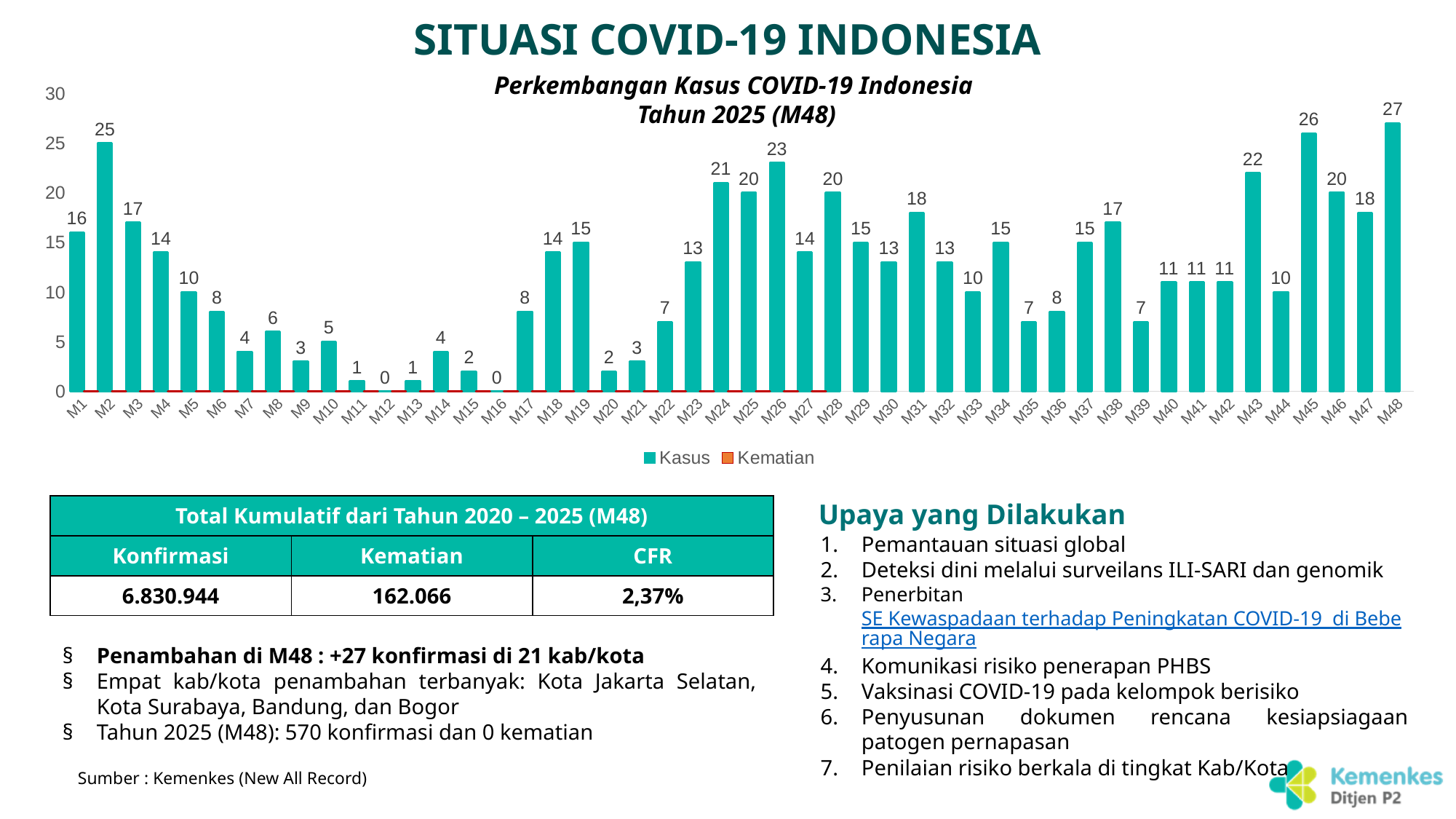
What is the value of Kasus for M2? 25 What is the difference in Kasus between M45 and M44? 16 Which week has more Kasus, M31 or M32? M31 How many series does the chart legend list? 2 Which week has more Kasus, M24 or M25? M24 How many weeks (categories) are shown on the x axis of the chart? 48 What is the difference in Kasus between M48 and M47? 9 What is the value of Kasus for M48? 27 Which week has the highest number of Kasus? M48 What type of chart is used to show the COVID-19 cases? Bar chart What is the value of Kasus for M26? 23 What is the title of the chart? Perkembangan Kasus COVID-19 Indonesia Tahun 2025 (M48)